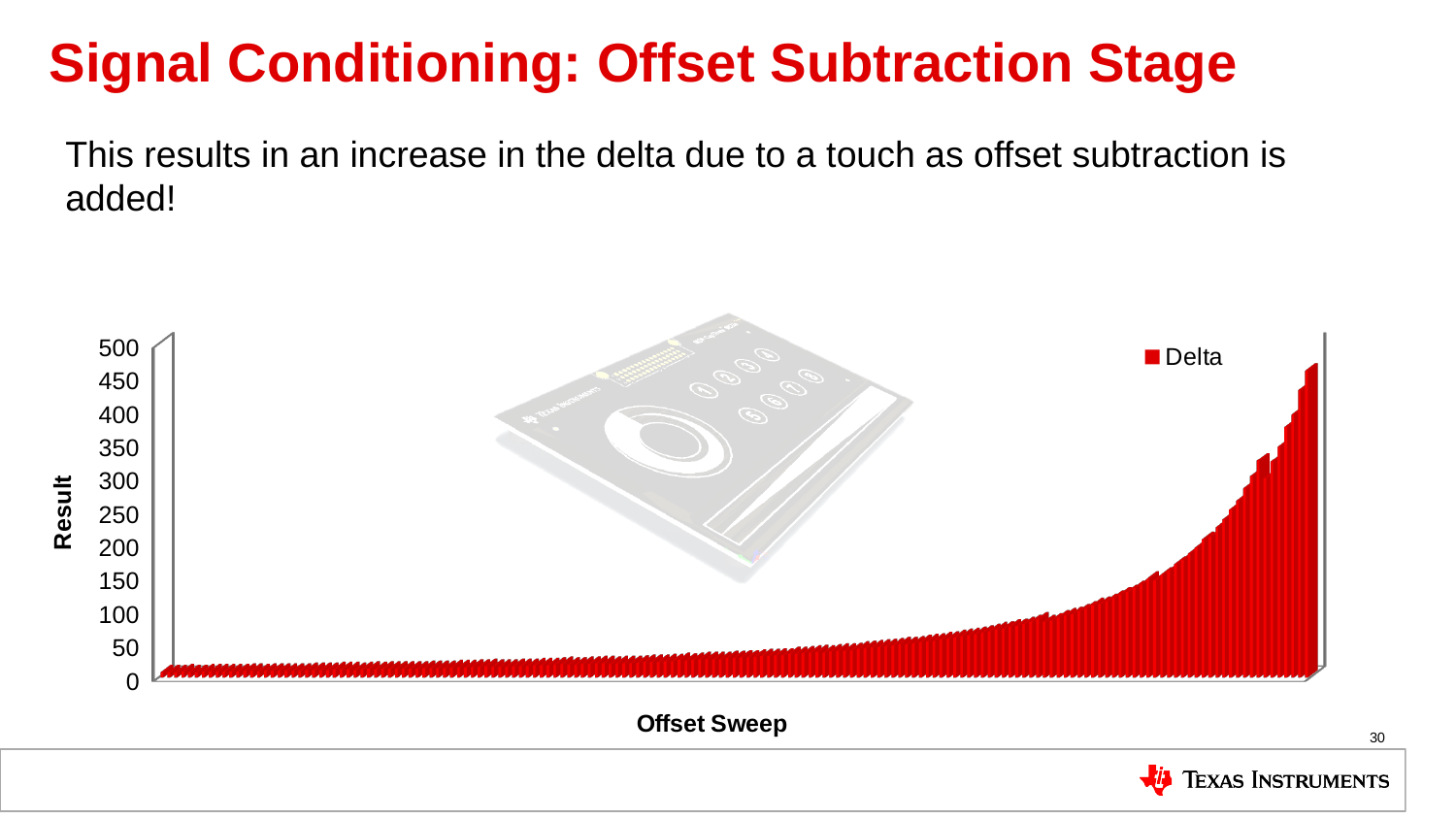
At which end of the Offset Sweep axis is the Delta value highest, the left end or the right end? right end What kind of chart is shown on the slide? bar chart Which is larger, the Delta value at the left end of the sweep or at the right end of the sweep? right end What is the title of the x axis of the chart? Offset Sweep Is the Delta value at the midpoint of the Offset Sweep greater or less than 100? less How many series does the chart legend list? 1 Do the Delta values rise or fall moving from left to right along the Offset Sweep axis? rise Is the tallest Delta bar greater or less than 400? greater Are the Delta bars at the left end of the Offset Sweep greater or less than 50? less What is the name of the series shown in the chart legend? Delta